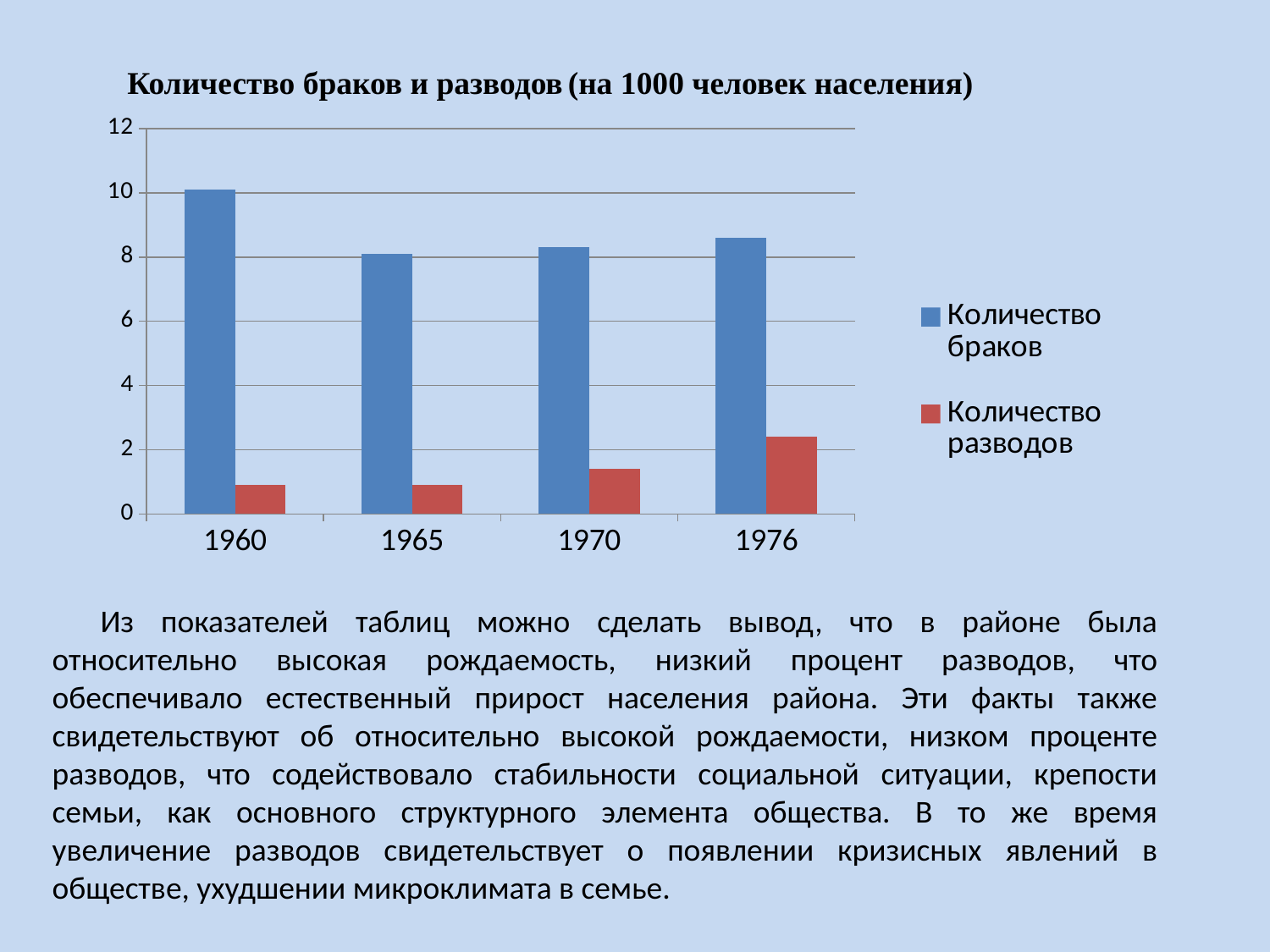
What kind of chart is shown on the slide? Bar chart In which year is the value for Количество разводов highest? 1976 How many years are shown on the x axis of the chart? 4 Is the value for Количество разводов in 1976 greater or less than 2? greater Do the values for Количество разводов rise or fall from 1960 to 1976? rise In which year is the value for Количество браков highest? 1960 Which series is shown in red in the chart? Количество разводов Which is larger: Количество браков in 1960 or Количество браков in 1976? 1960 What is the title of the chart? Количество браков и разводов (на 1000 человек населения) How many series does the chart legend list? 2 Is the value for Количество браков in 1960 greater or less than 8? greater Is the value for Количество разводов in 1970 greater or less than 2? less